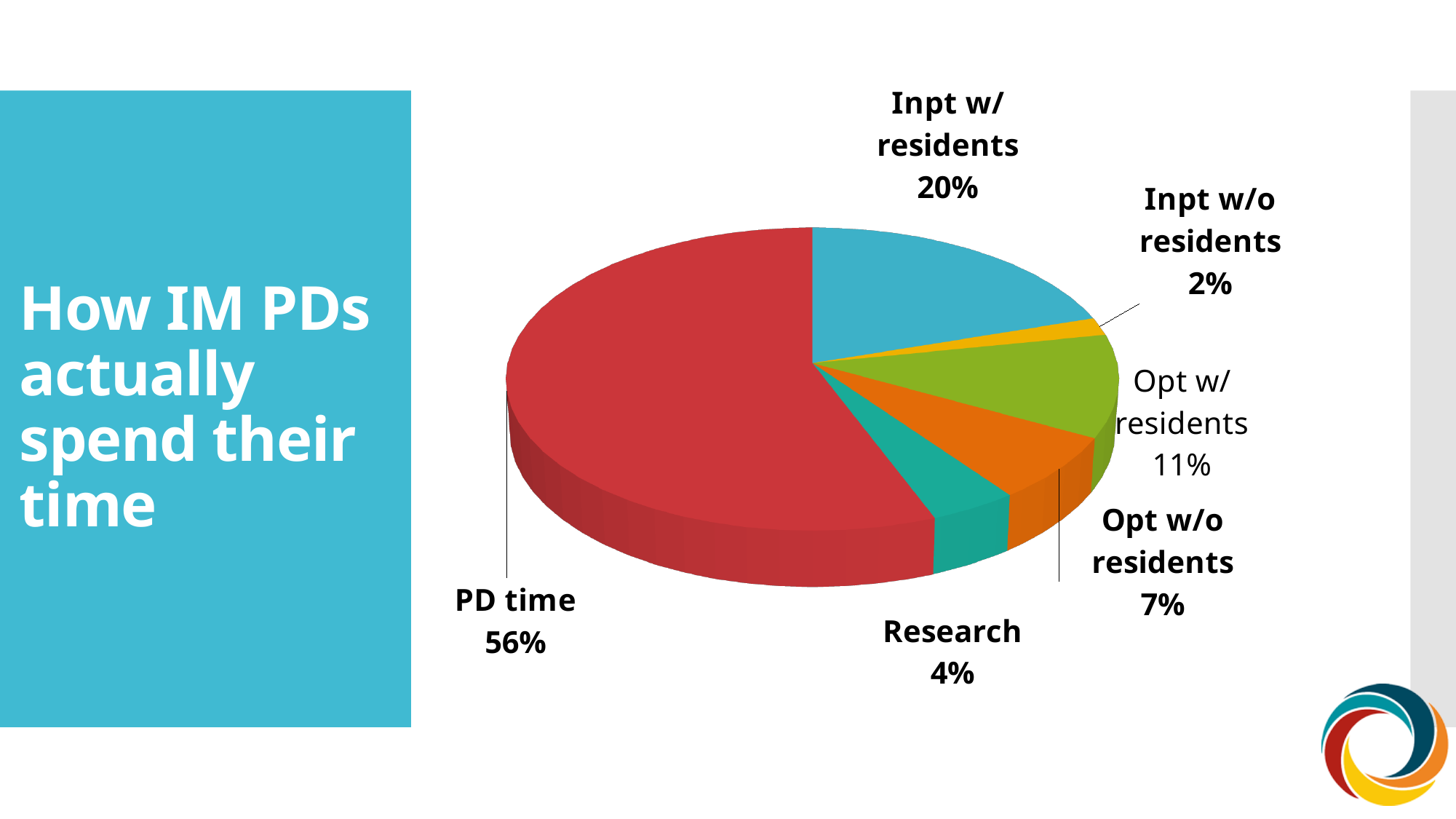
What kind of chart is shown on the slide? Pie chart What is the difference in percentage points between PD time and Inpt w/ residents? 36 What percentage is shown for Opt w/ residents? 11% Which category has the smallest slice of the pie? Inpt w/o residents What colour is the PD time slice? Red What percentage is shown for Research? 4% What share of time is labelled for PD time? 56% What is the title of the slide? How IM PDs actually spend their time Which is larger, Opt w/ residents or Opt w/o residents? Opt w/ residents What percentage is shown for Inpt w/ residents? 20% Which category has the largest slice of the pie? PD time How many categories are shown in the pie chart? 6